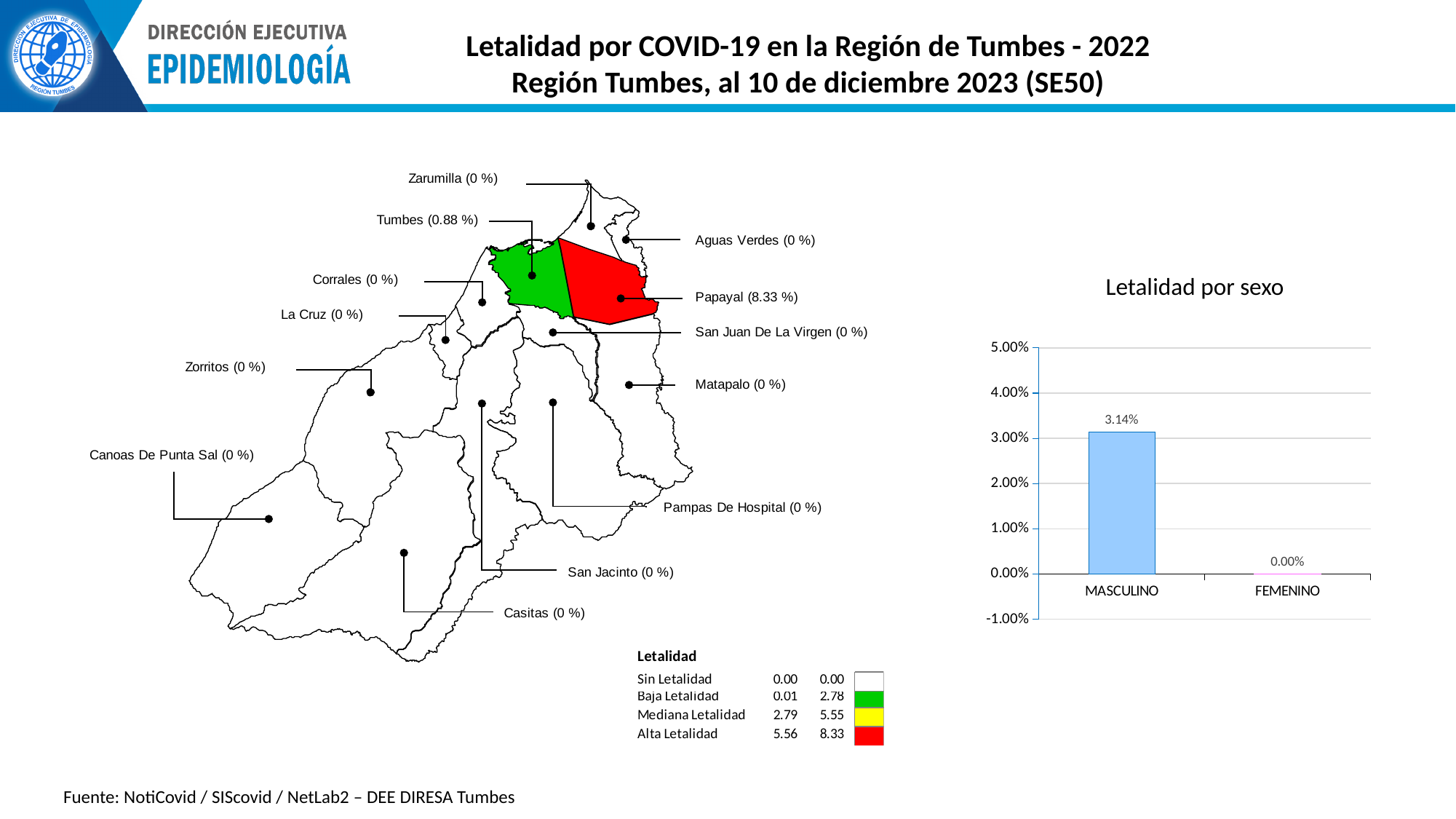
In the 'Letalidad por sexo' chart, what is the difference between the MASCULINO and FEMENINO values? 3.14% In the 'Letalidad por sexo' chart, is the value for MASCULINO greater or less than 3.00%? greater How many categories are shown in the 'Letalidad por sexo' chart? 2 In the 'Letalidad por sexo' chart, what is the value for FEMENINO? 0.00% On the map on the left, which district has the highest lethality value? Papayal In the 'Letalidad por sexo' chart, what is the value for MASCULINO? 3.14% In the 'Letalidad por sexo' chart, what is the highest value shown on the vertical axis? 5.00% In the 'Letalidad por sexo' chart, which category has the lowest value? FEMENINO On the map on the left, what is the lethality value shown for Tumbes? 0.88 % In the 'Letalidad por sexo' chart, which category has the highest value? MASCULINO On the map on the left, what is the lethality value shown for Papayal? 8.33 % What kind of chart is 'Letalidad por sexo'? bar chart